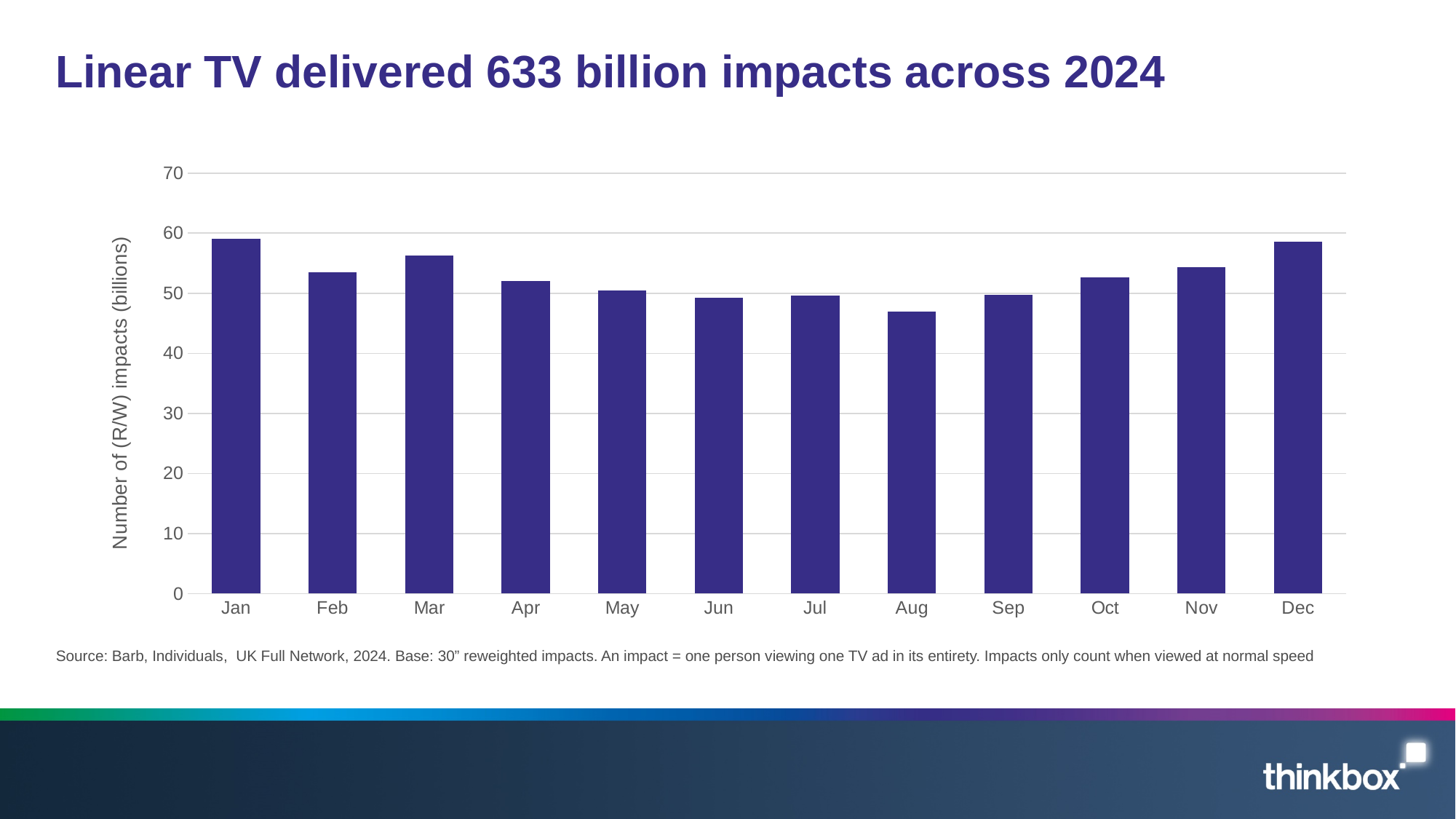
How many months are plotted on the chart? 12 Is the value for Dec greater or less than 50? greater Is the value for Jan greater or less than 50? greater Which is larger, the value for Mar or the value for Feb? Mar Which is larger, the value for Jan or the value for Aug? Jan What kind of chart is shown on the slide? Bar chart Is the value for Mar greater or less than 60? less Which is larger, the value for Dec or the value for Jun? Dec Which month has the lowest number of impacts? Aug Do the values generally rise or fall from Jan to Aug? Fall What is the title of the slide? Linear TV delivered 633 billion impacts across 2024